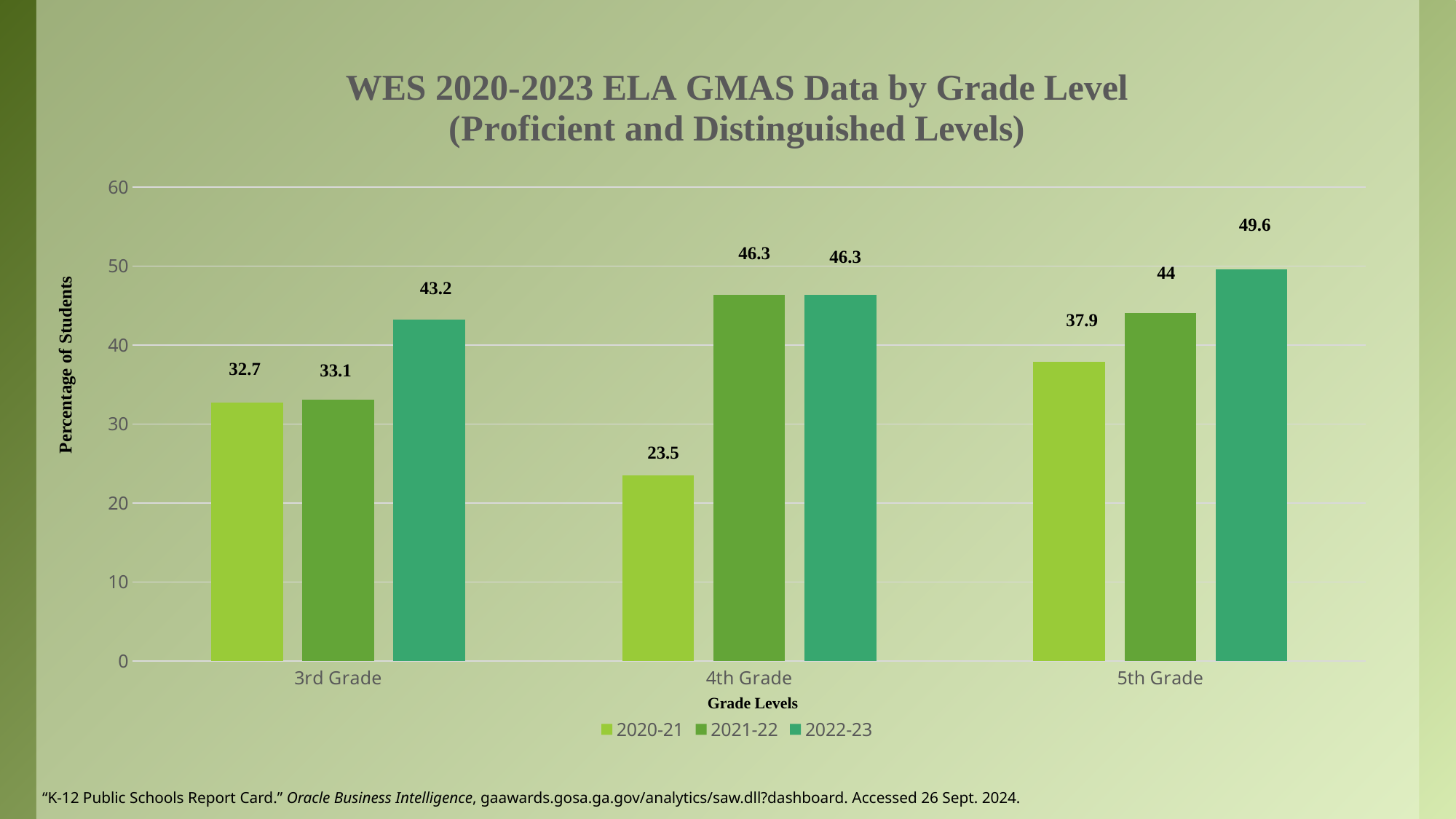
What is the value for 5th Grade in the 2021-22 series? 44 Is the value for 3rd Grade in 2022-23 greater or less than 40? greater Which grade level has the highest value in the 2022-23 series? 5th Grade What is the difference between the 2022-23 and 2020-21 values for 4th Grade? 22.8 Do the 2020-21 values rise or fall from 3rd Grade to 4th Grade? Fall Which is larger for 5th Grade: the 2020-21 value or the 2022-23 value? 2022-23 Which grade level has the lowest value in the 2020-21 series? 4th Grade What is the value for 3rd Grade in the 2020-21 series? 32.7 What kind of chart is shown on the slide? Bar chart How many grade levels are shown on the x axis? 3 What is the value for 4th Grade in the 2022-23 series? 46.3 How many series does the legend list? 3